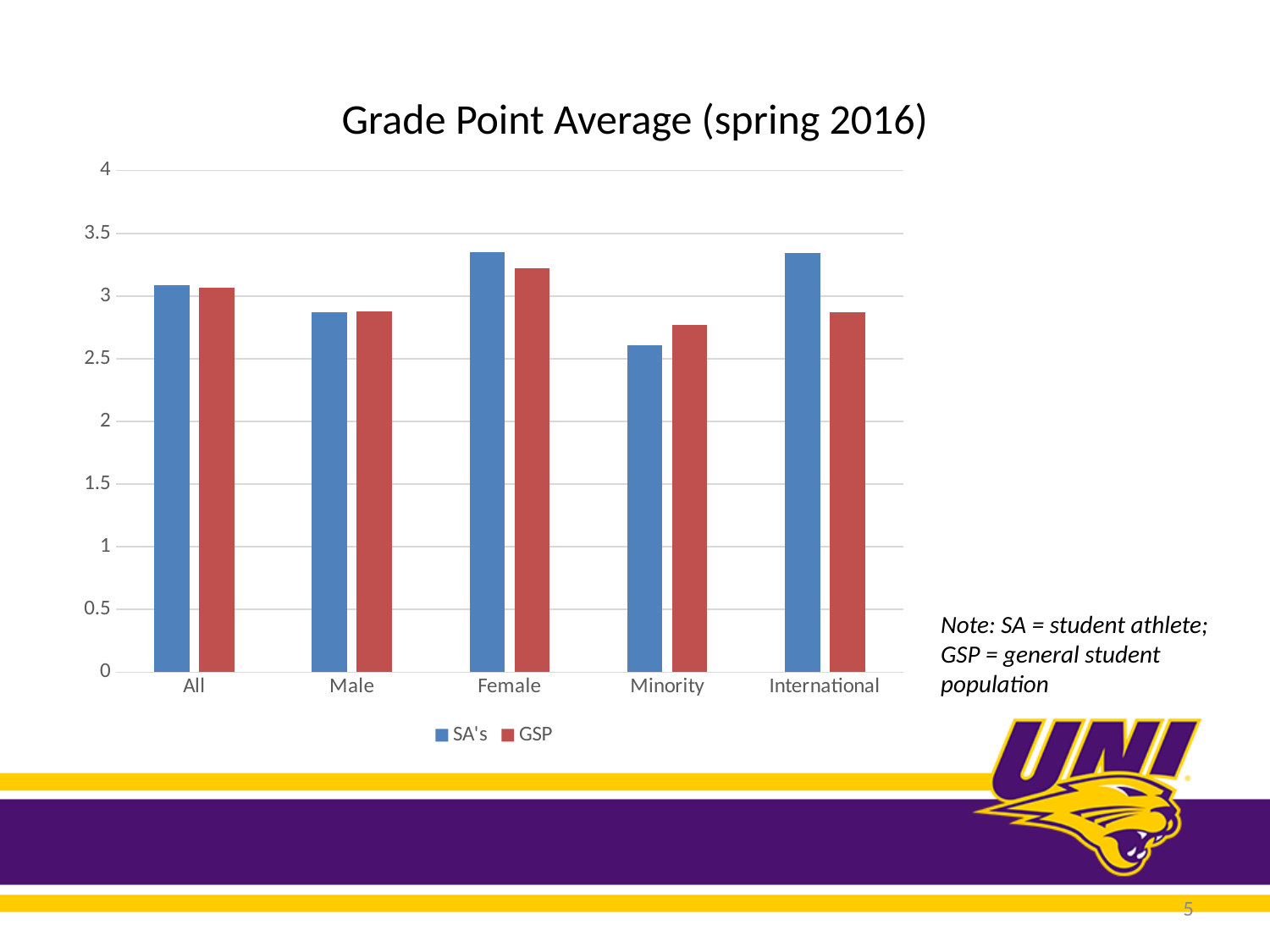
For the Minority category, which is larger, SA's or GSP? GSP Which category has the highest GSP value? Female Is the SA's value for Minority greater or less than 3? less How many categories are shown on the x axis? 5 How many series does the legend list? 2 What kind of chart is shown on the slide? bar chart What is the title of the chart? Grade Point Average (spring 2016) For the International category, which is larger, SA's or GSP? SA's Which category has the lowest SA's value? Minority Which series is shown in red in the legend? GSP Is the SA's value for International greater or less than 3? greater Is the GSP value for Male greater or less than 3? less